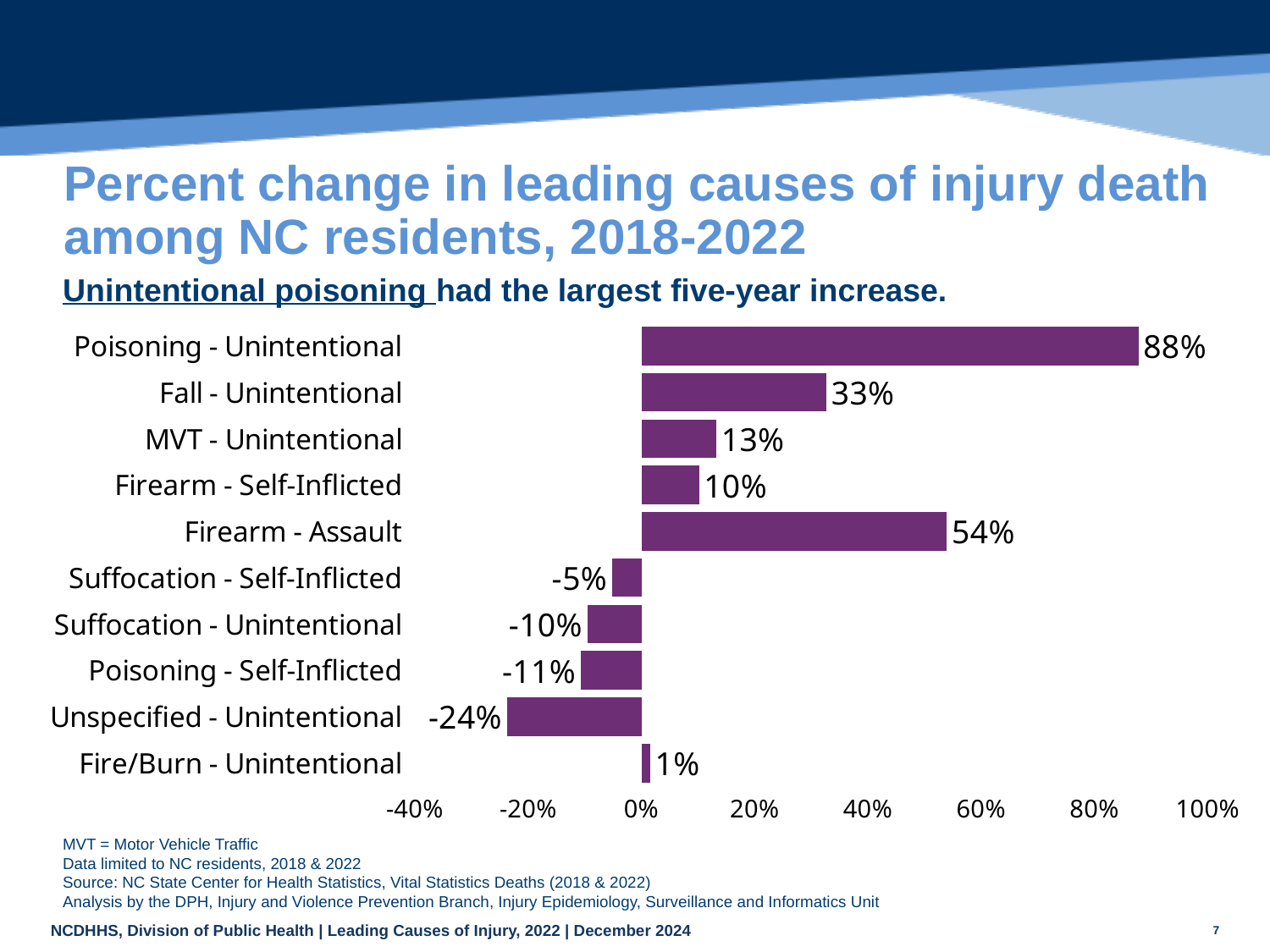
What is the percent change for Firearm - Assault? 54% Which cause of injury death has the highest percent change? Poisoning - Unintentional What is the difference between the percent change for Poisoning - Unintentional and Firearm - Assault? 34 percentage points What kind of chart is shown on the slide? Bar chart What is the percent change for Unspecified - Unintentional? -24% What does MVT stand for according to the slide? Motor Vehicle Traffic How many causes of injury death show a negative percent change? 4 Which has a larger percent change, MVT - Unintentional or Firearm - Self-Inflicted? MVT - Unintentional How many causes of injury death are shown in the chart? 10 Which cause of injury death has the lowest percent change? Unspecified - Unintentional Is the value for Fall - Unintentional greater or less than 20%? greater What is the percent change for Fall - Unintentional? 33%